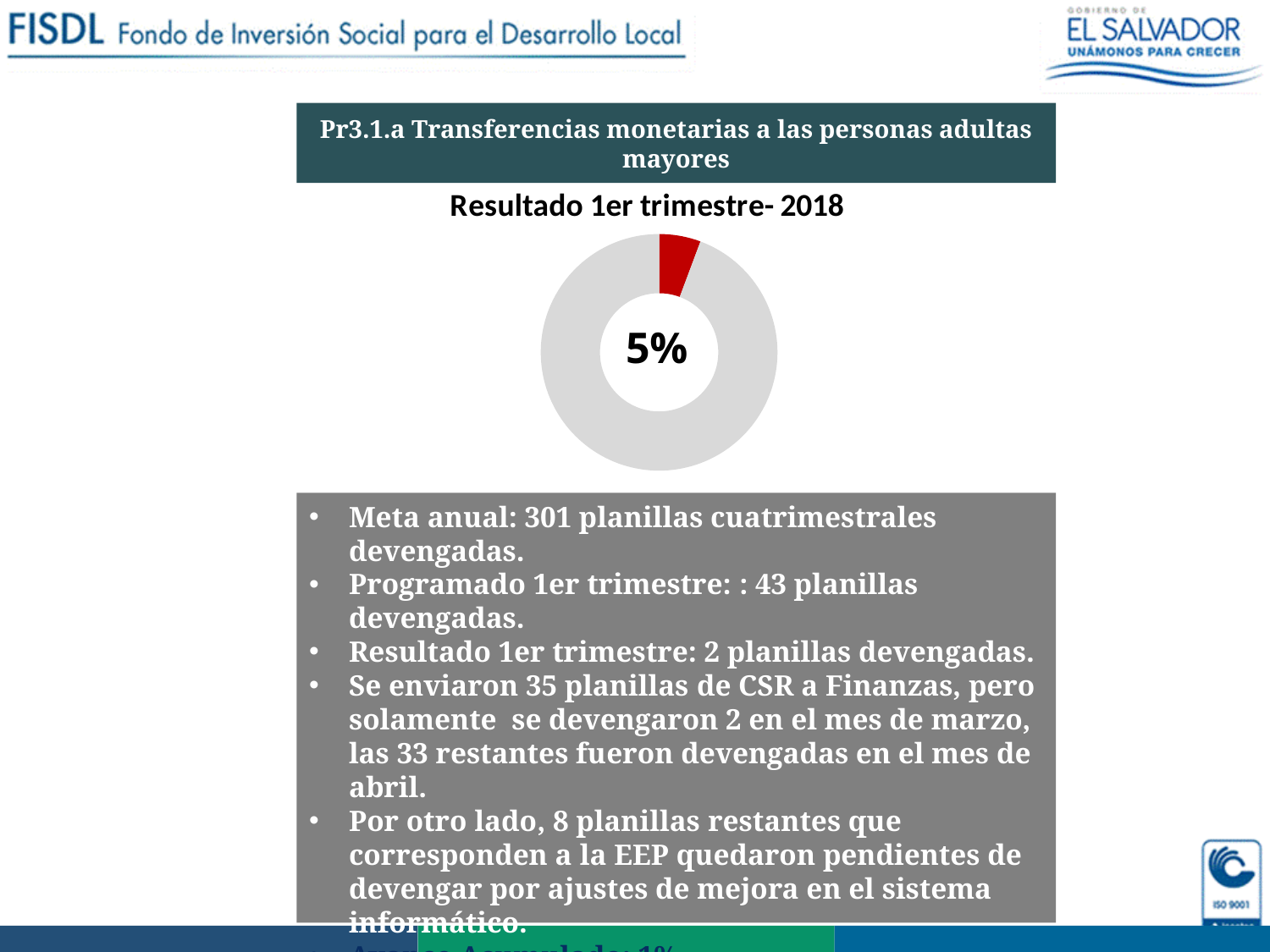
What colour is the small slice of the doughnut chart? Red Which slice of the doughnut chart is larger, the red one or the grey one? The grey one What share of the doughnut chart does the red slice represent? 5% How many slices does the doughnut chart have? 2 Which slice of the doughnut chart is the smallest? The red slice What percentage is printed in the centre of the doughnut chart? 5% What is the title shown above the doughnut chart? Resultado 1er trimestre- 2018 What kind of chart is shown on the slide? Doughnut (pie) chart